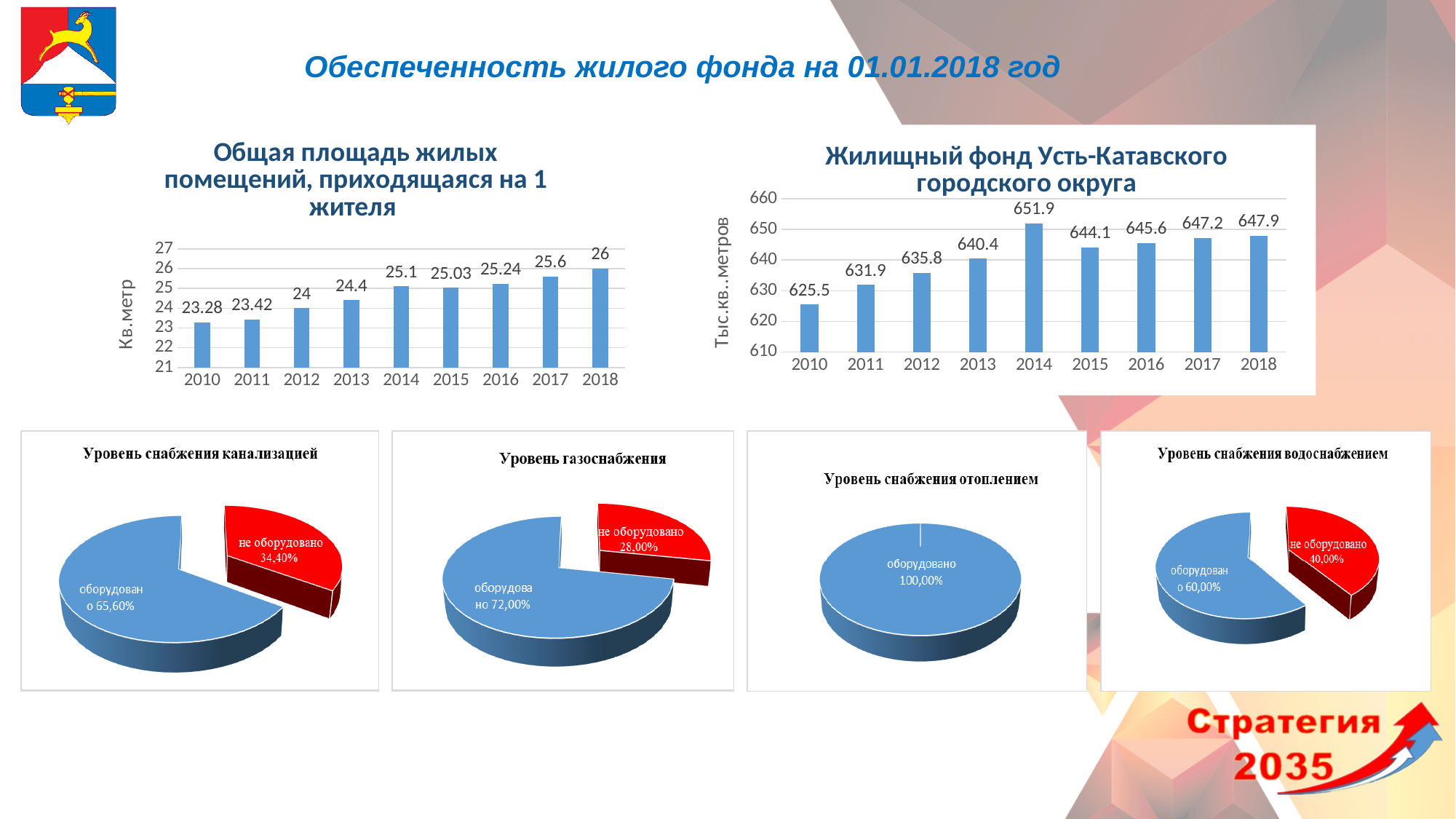
In the chart 'Общая площадь жилых помещений, приходящаяся на 1 жителя', what is the value for 2014? 25.1 In the chart 'Общая площадь жилых помещений, приходящаяся на 1 жителя', how many years are shown on the x axis? 9 In the chart 'Общая площадь жилых помещений, приходящаяся на 1 жителя', what is the difference between the 2018 and 2010 values? 2.72 In the pie chart 'Уровень снабжения канализацией', what share is labelled 'не оборудовано'? 34,40% In the chart 'Жилищный фонд Усть-Катавского городского округа', what is the value for 2013? 640.4 In the chart 'Жилищный фонд Усть-Катавского городского округа', which year has the highest value? 2014 What type of chart is 'Жилищный фонд Усть-Катавского городского округа'? Bar chart In the chart 'Жилищный фонд Усть-Катавского городского округа', which is larger, the value for 2015 or the value for 2016? 2016 In the pie chart 'Уровень снабжения водоснабжением', what share is labelled 'не оборудовано'? 40,00% In the chart 'Жилищный фонд Усть-Катавского городского округа', what is the difference between the 2014 and 2015 values? 7.8 In the chart 'Общая площадь жилых помещений, приходящаяся на 1 жителя', which year has the lowest value? 2010 In the pie chart 'Уровень газоснабжения', what share is labelled 'оборудовано'? 72,00%